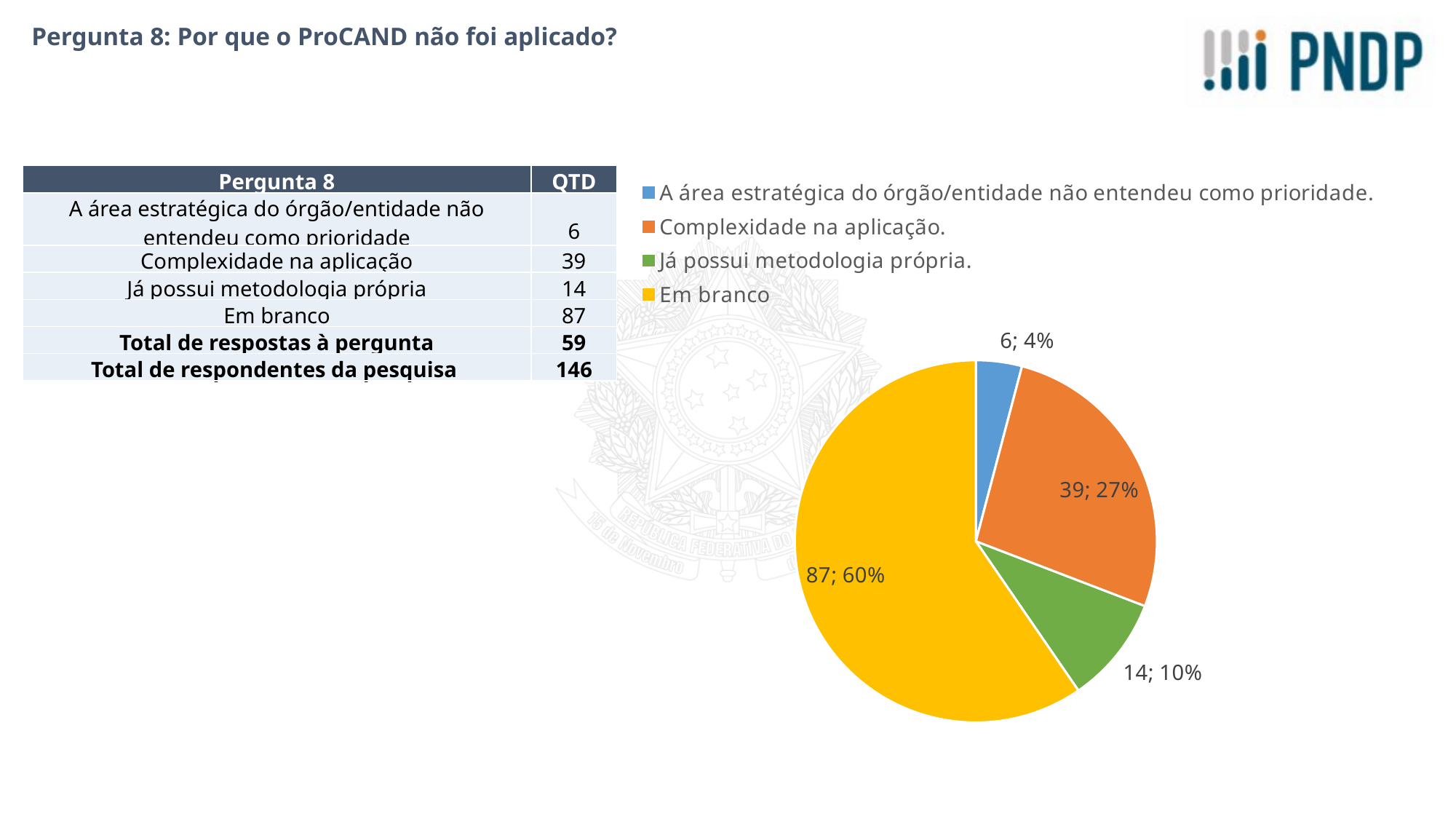
What is the difference between the values for "Em branco" and "Complexidade na aplicação"? 48 How many slices does the pie chart have? 4 What share of the pie does "Complexidade na aplicação" represent? 27% What is the value for "A área estratégica do órgão/entidade não entendeu como prioridade" in the pie chart? 6 What kind of chart is shown on the slide? pie chart Which colour represents "Em branco" in the pie chart? yellow What is the value for "Complexidade na aplicação" in the pie chart? 39 Which category has the smallest slice in the pie chart? A área estratégica do órgão/entidade não entendeu como prioridade What share of the pie does "Já possui metodologia própria" represent? 10% What is the value for "Em branco" in the pie chart? 87 Which category has the largest slice in the pie chart? Em branco What is the value for "Já possui metodologia própria" in the pie chart? 14